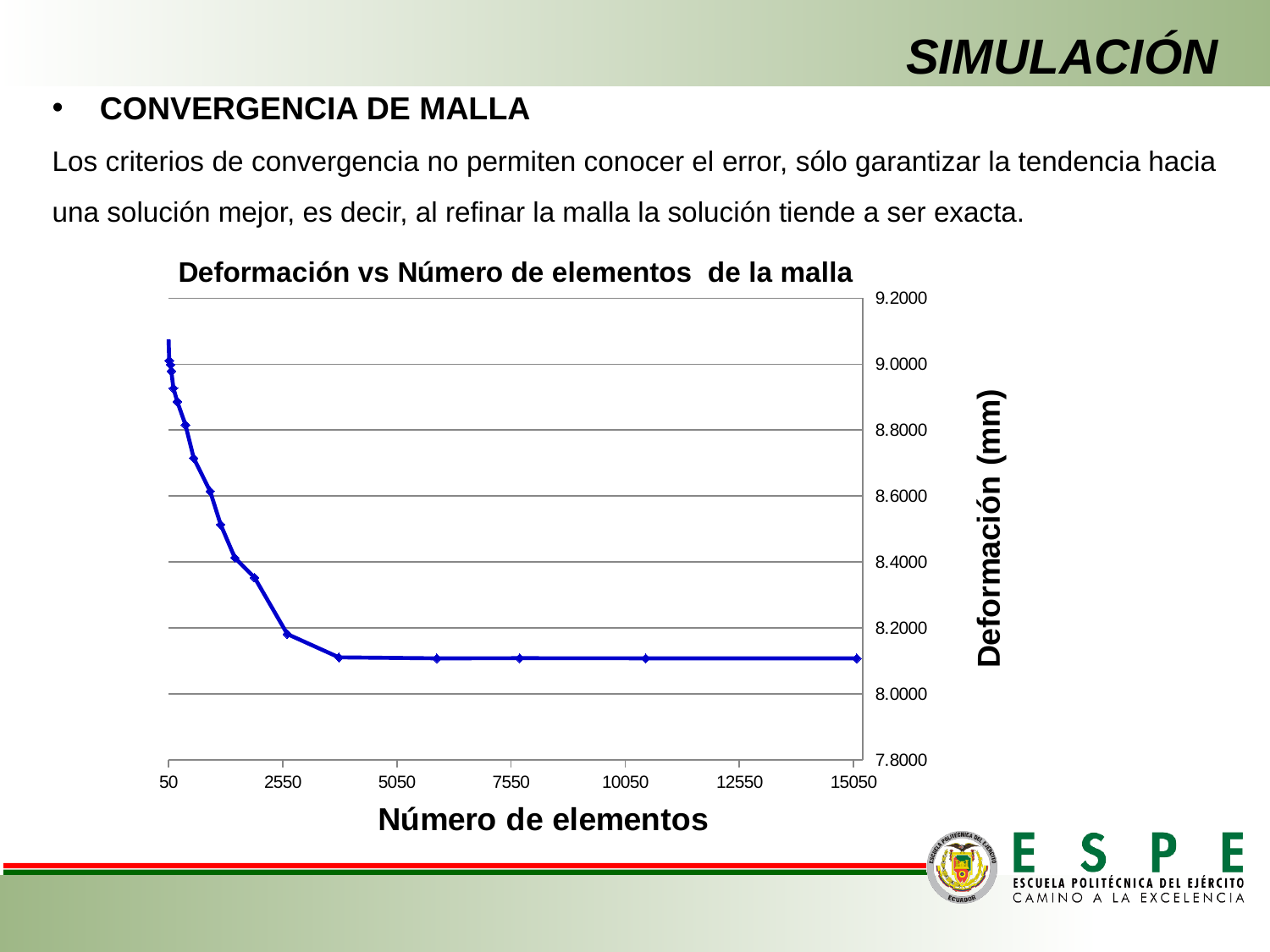
Is the deformation value at 15050 elements greater or less than 8.0000? greater Is the deformation value at 10050 elements greater or less than 8.4000? less What is the label of the vertical axis of the chart? Deformación (mm) Is the deformation value at 7550 elements greater or less than 8.2000? less Do the deformation values rise or fall as the number of elements increases along the x axis? Fall Which has the larger deformation value, 50 elements or 15050 elements? 50 elements What is the title of the chart? Deformación vs Número de elementos de la malla What is the highest value shown on the vertical axis of the chart? 9.2000 Which has the larger deformation value, 2550 elements or 12550 elements? 2550 elements What kind of chart is shown on the slide? Line chart